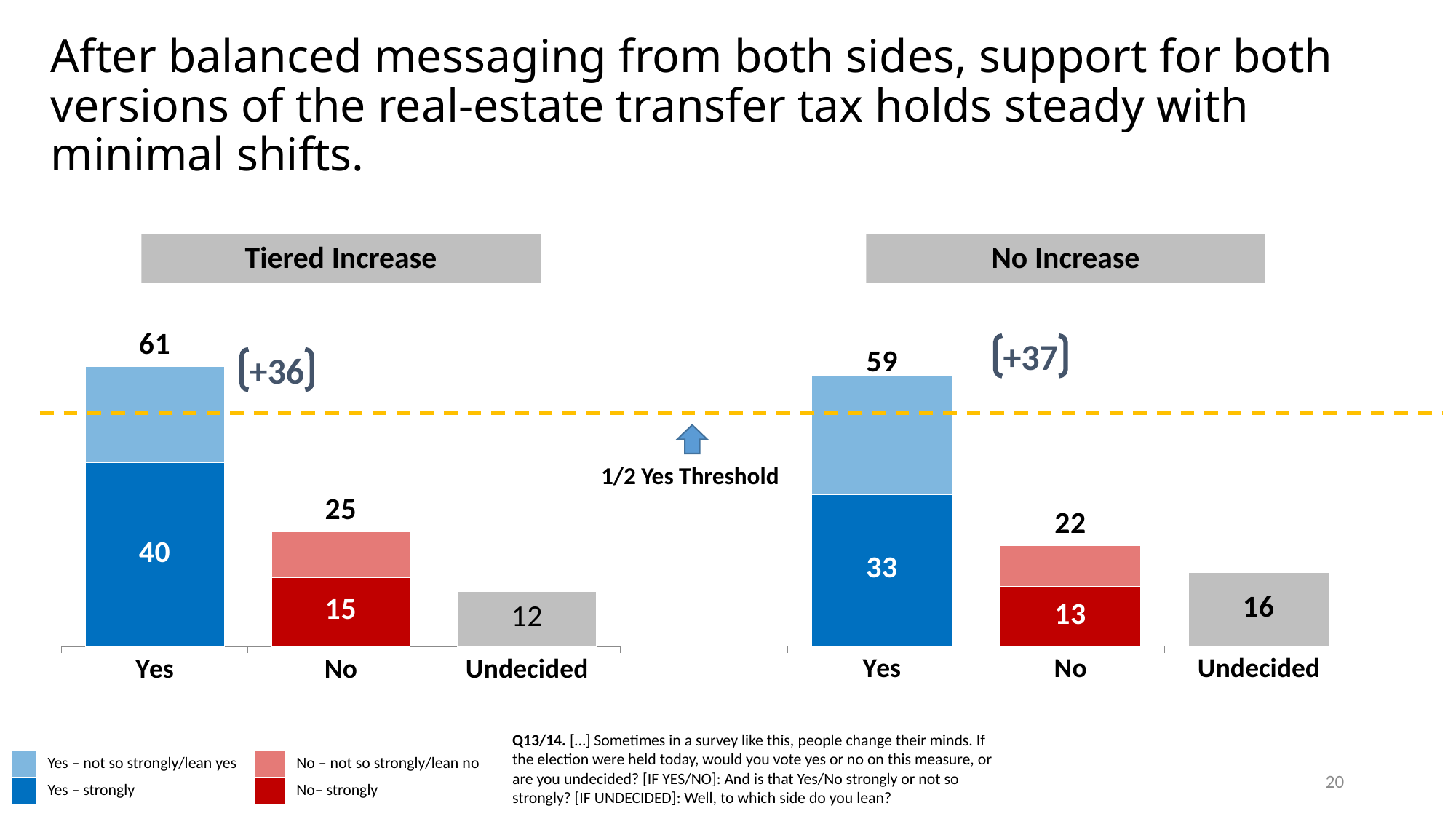
In the No Increase chart, what is the difference between the Yes total and the No total? 37 Is the Undecided value larger in the Tiered Increase chart or the No Increase chart? No Increase In the No Increase chart, what is the value for Yes – strongly? 33 What type of chart is used for the Tiered Increase data? Stacked bar chart In the No Increase chart, which category has the lowest total? Undecided In the Tiered Increase chart, what is the total value of the Yes bar? 61 In the Tiered Increase chart, what is the value for Undecided? 12 How many categories are shown on the x axis of the Tiered Increase chart? 3 What does the dashed horizontal line across the charts represent? 1/2 Yes Threshold In the Tiered Increase chart, what is the difference between the Yes total and the No total? 36 In the Tiered Increase chart, which category has the highest total? Yes In the No Increase chart, what is the value for No– strongly? 13